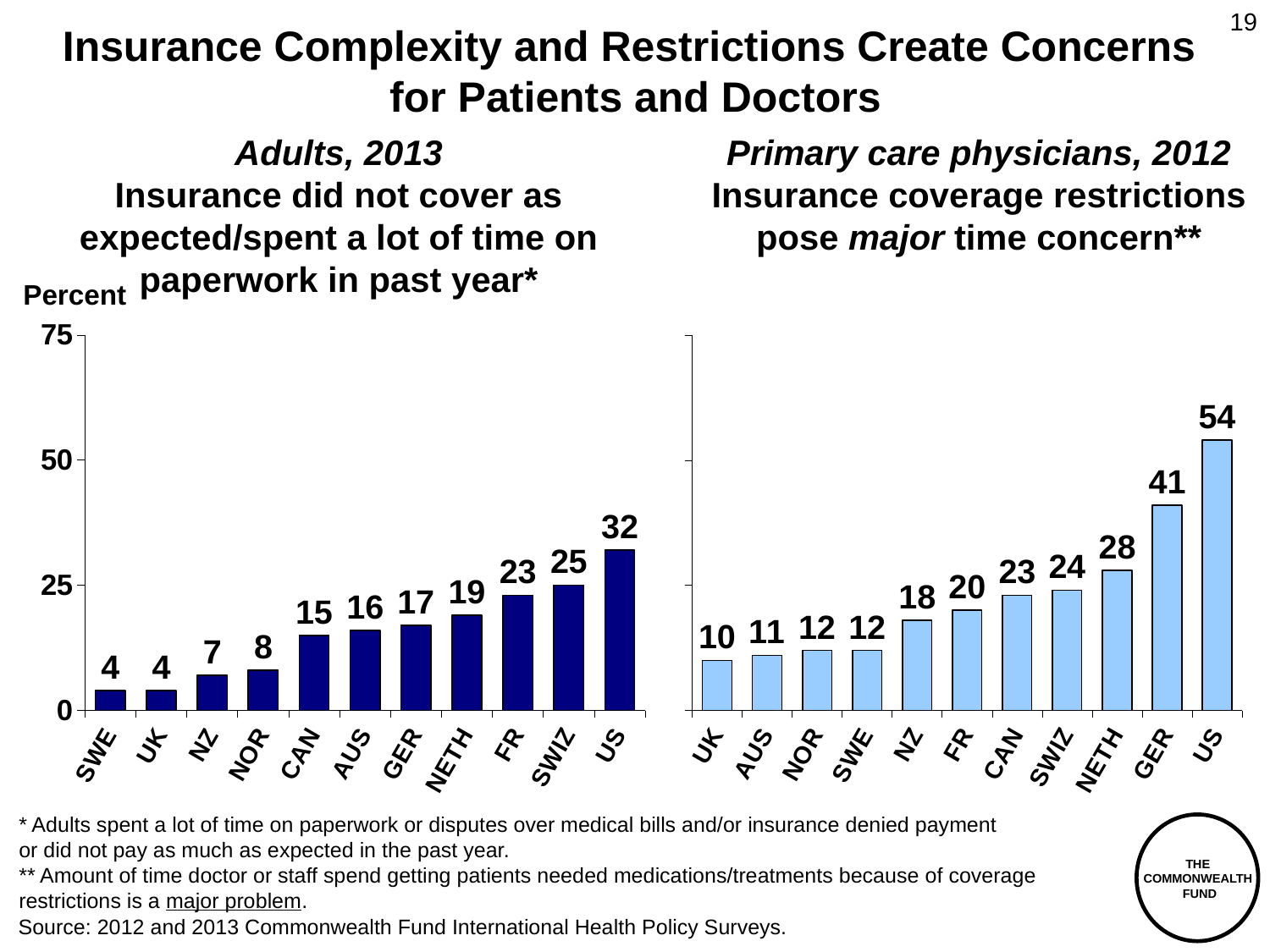
How many countries are shown in the Adults, 2013 chart on the left? 11 In the Primary care physicians, 2012 chart on the right, do the values rise or fall from left to right along the x axis? rise In the Primary care physicians, 2012 chart on the right, what is the difference between the values for US and GER? 13 What is the label on the vertical axis of the left chart? Percent In the Adults, 2013 chart on the left, what is the difference between the values for US and SWIZ? 7 In the Primary care physicians, 2012 chart on the right, which country has the lowest value? UK In the Adults, 2013 chart on the left, is the value for FR greater or less than 25? less In the Adults, 2013 chart on the left, what is the value for CAN? 15 In the Primary care physicians, 2012 chart on the right, what is the value for GER? 41 In the Adults, 2013 chart on the left, which country has the highest value? US In the Primary care physicians, 2012 chart on the right, which is larger, the value for NZ or the value for CAN? CAN What kind of chart is the Primary care physicians, 2012 chart on the right? bar chart